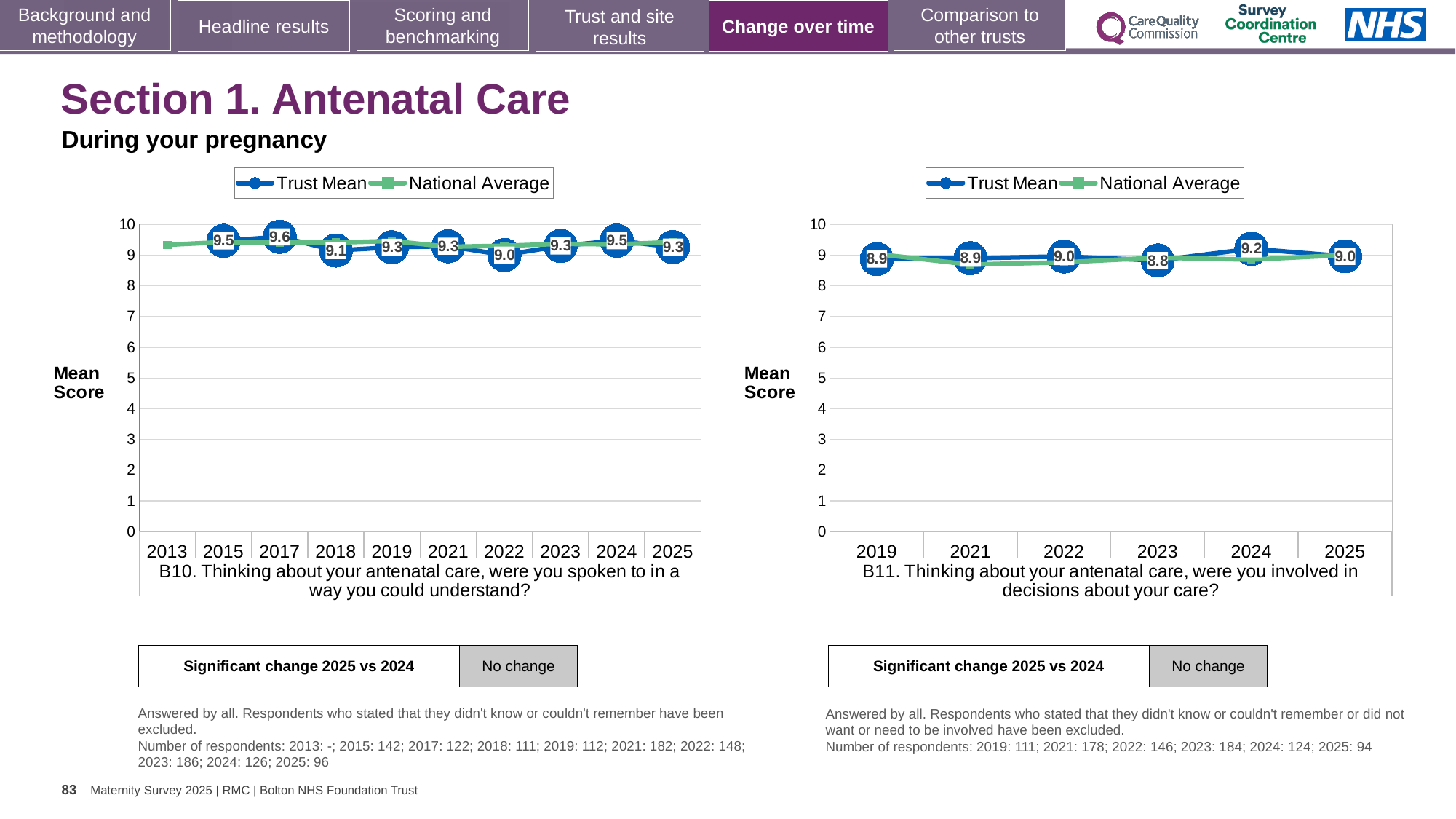
In the left chart (B10), which year has the highest Trust Mean? 2017 In the left chart (B10), what is the difference between the Trust Mean for 2024 and 2025? 0.2 In the right chart (B11), what is the Trust Mean for 2024? 9.2 What kind of chart is the right chart (B11)? Line chart In the right chart (B11), what is the difference between the Trust Mean for 2024 and 2023? 0.4 In the left chart (B10), which year has the lowest labelled Trust Mean? 2022 In the left chart (B10), what is the Trust Mean for 2017? 9.6 In the left chart (B10), how many series does the legend list? 2 In the right chart (B11), which year has the highest Trust Mean? 2024 In the left chart (B10), what is the Trust Mean for 2022? 9.0 In the right chart (B11), what is the Trust Mean for 2023? 8.8 In the right chart (B11), how many years are shown on the x axis? 6